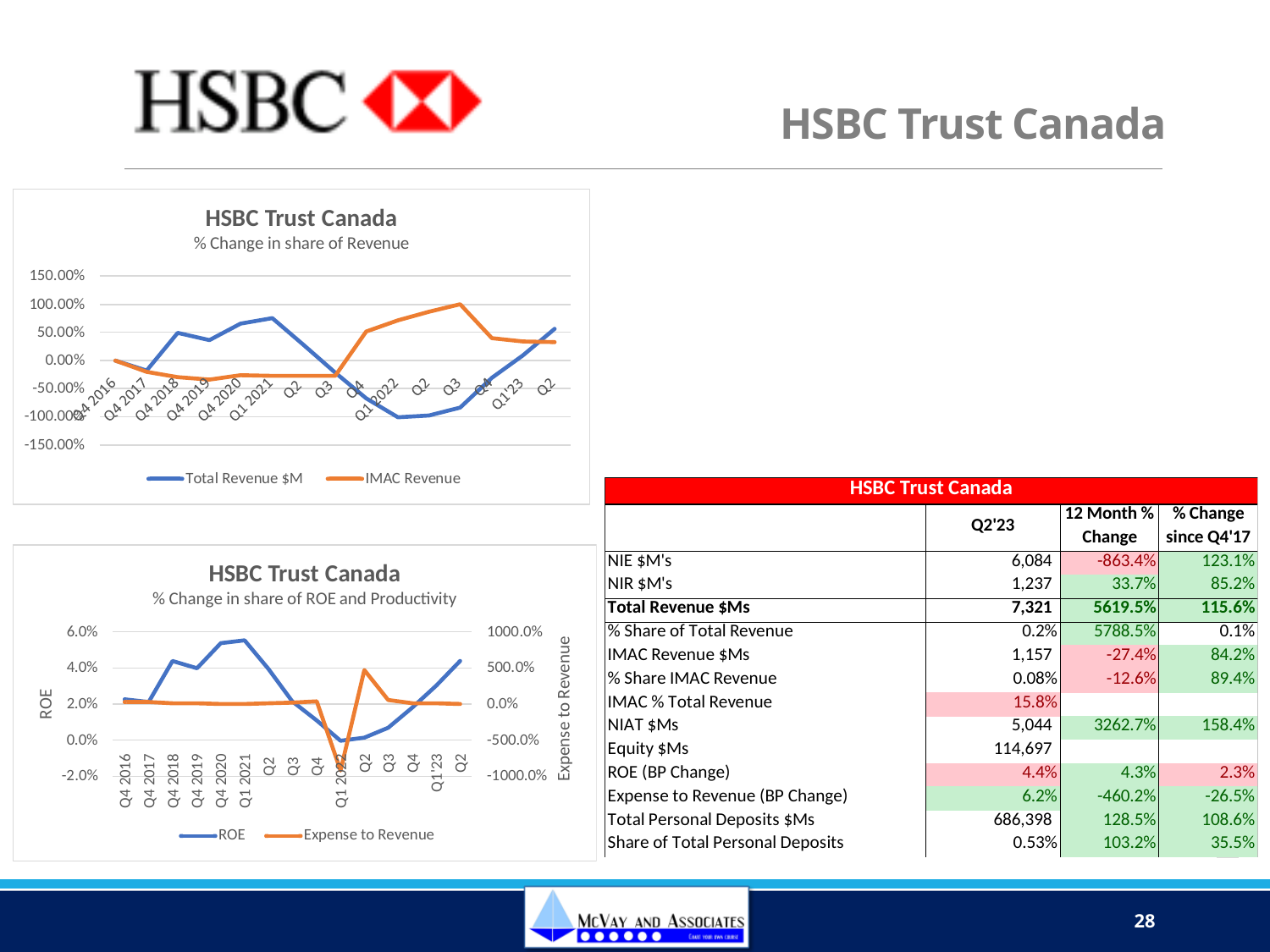
In the top chart (% Change in share of Revenue), which series is shown in orange? IMAC Revenue In the bottom chart (% Change in share of ROE and Productivity), at which period does the ROE line reach its highest point? Q1 2021 In the top chart (% Change in share of Revenue), at which period does the Total Revenue $M line reach its lowest point? Q1 2022 In the top chart (% Change in share of Revenue), is the IMAC Revenue value at Q3 2022 greater or less than 50.00%? greater In the top chart (% Change in share of Revenue), does the Total Revenue $M line rise or fall from Q1 2022 to Q2 2023? Rise In the top chart (% Change in share of Revenue), is the Total Revenue $M value at Q1 2022 greater or less than -50.00%? less In the bottom chart (% Change in share of ROE and Productivity), is the Expense to Revenue value at Q1 2022 greater or less than -500.0%? less How many series does the legend of the bottom chart (% Change in share of ROE and Productivity) list? 2 How many series does the legend of the top chart (% Change in share of Revenue) list? 2 In the top chart (% Change in share of Revenue), at which period does the IMAC Revenue line reach its highest point? Q3 (2022) What kind of chart is the top chart titled 'HSBC Trust Canada % Change in share of Revenue'? Line chart What kind of chart is the bottom chart titled 'HSBC Trust Canada % Change in share of ROE and Productivity'? Line chart